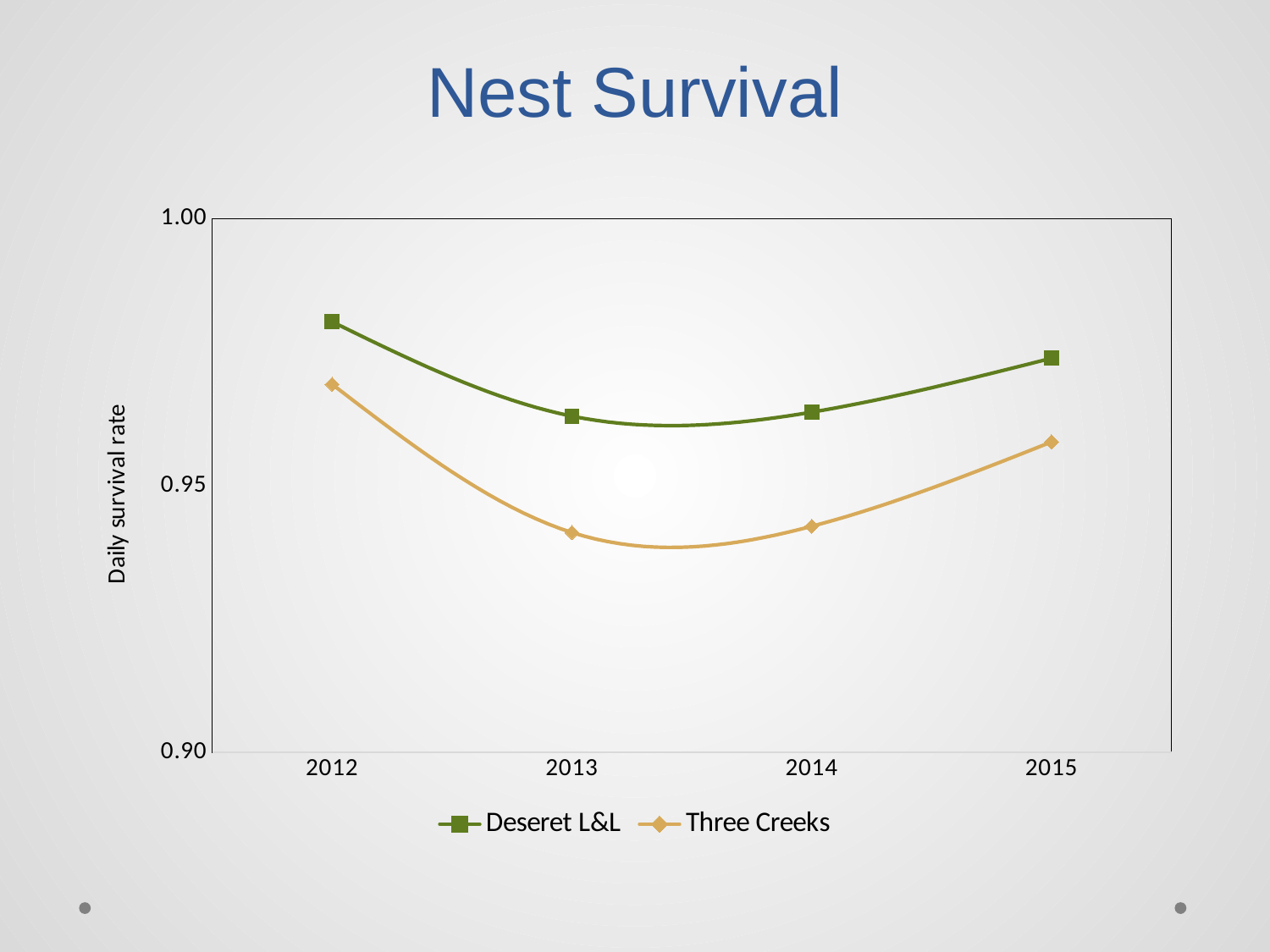
Is the value for Deseret L&L in 2012 greater or less than 0.95? greater Is the value for Three Creeks in 2014 greater or less than 0.95? less Is the value for Three Creeks in 2013 greater or less than 0.95? less Does the Deseret L&L daily survival rate rise or fall from 2012 to 2013? Fall What kind of chart is shown on the slide? Line chart Which series has the higher daily survival rate in 2013, Deseret L&L or Three Creeks? Deseret L&L In which year is the Deseret L&L daily survival rate highest? 2012 In which year is the Three Creeks daily survival rate highest? 2012 What is the label on the vertical axis? Daily survival rate How many years are plotted along the x axis? 4 How many series does the legend list? 2